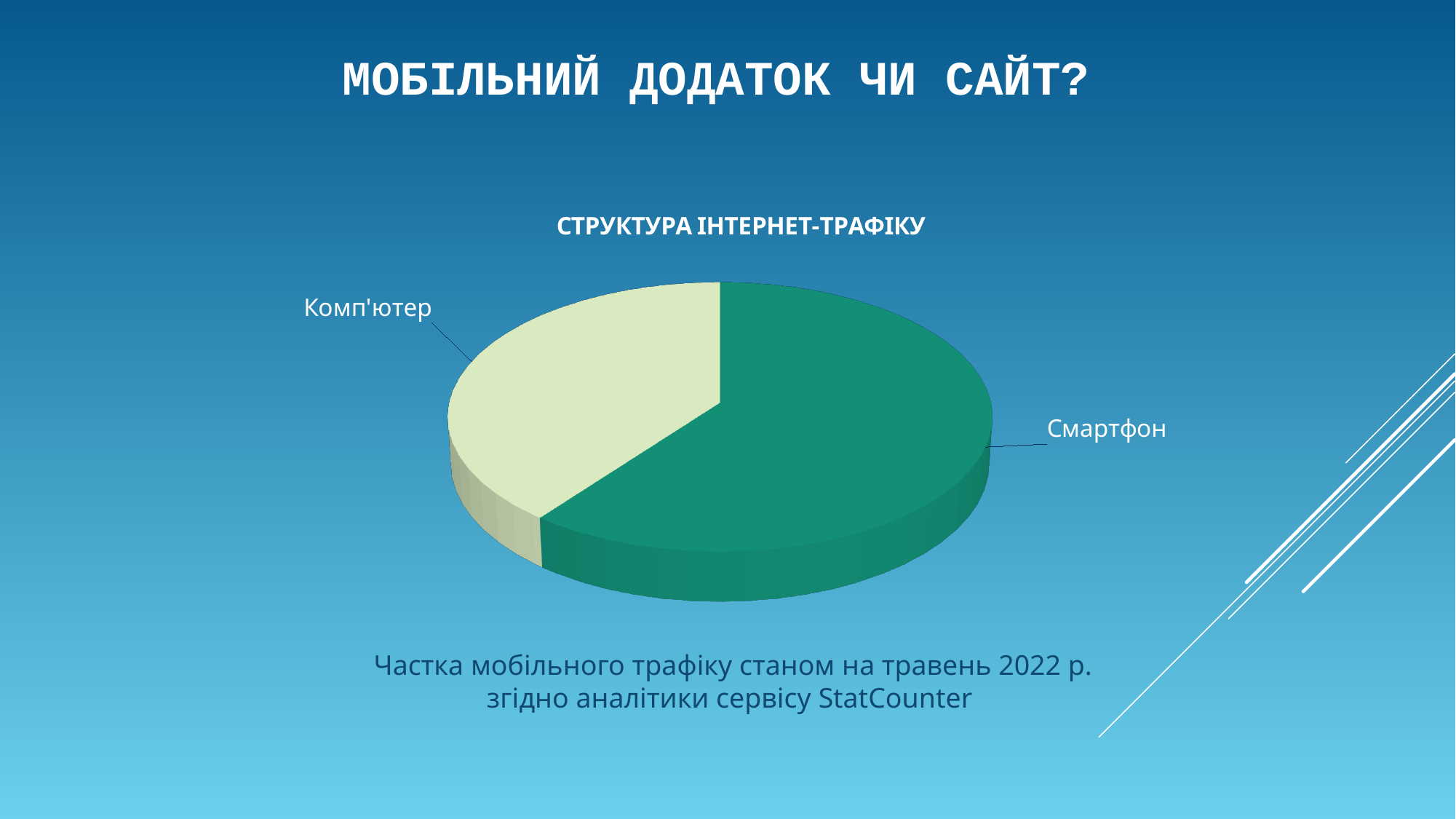
What is the title of the pie chart? СТРУКТУРА ІНТЕРНЕТ-ТРАФІКУ Which category has the smallest slice in the pie chart? Комп'ютер Which category is shown in the dark green slice? Смартфон Which slice is larger, Смартфон or Комп'ютер? Смартфон Does the Смартфон slice account for more or less than half of the pie? More How many slices does the pie chart have? 2 Which category has the largest slice in the pie chart? Смартфон What kind of chart is shown on the slide? Pie chart